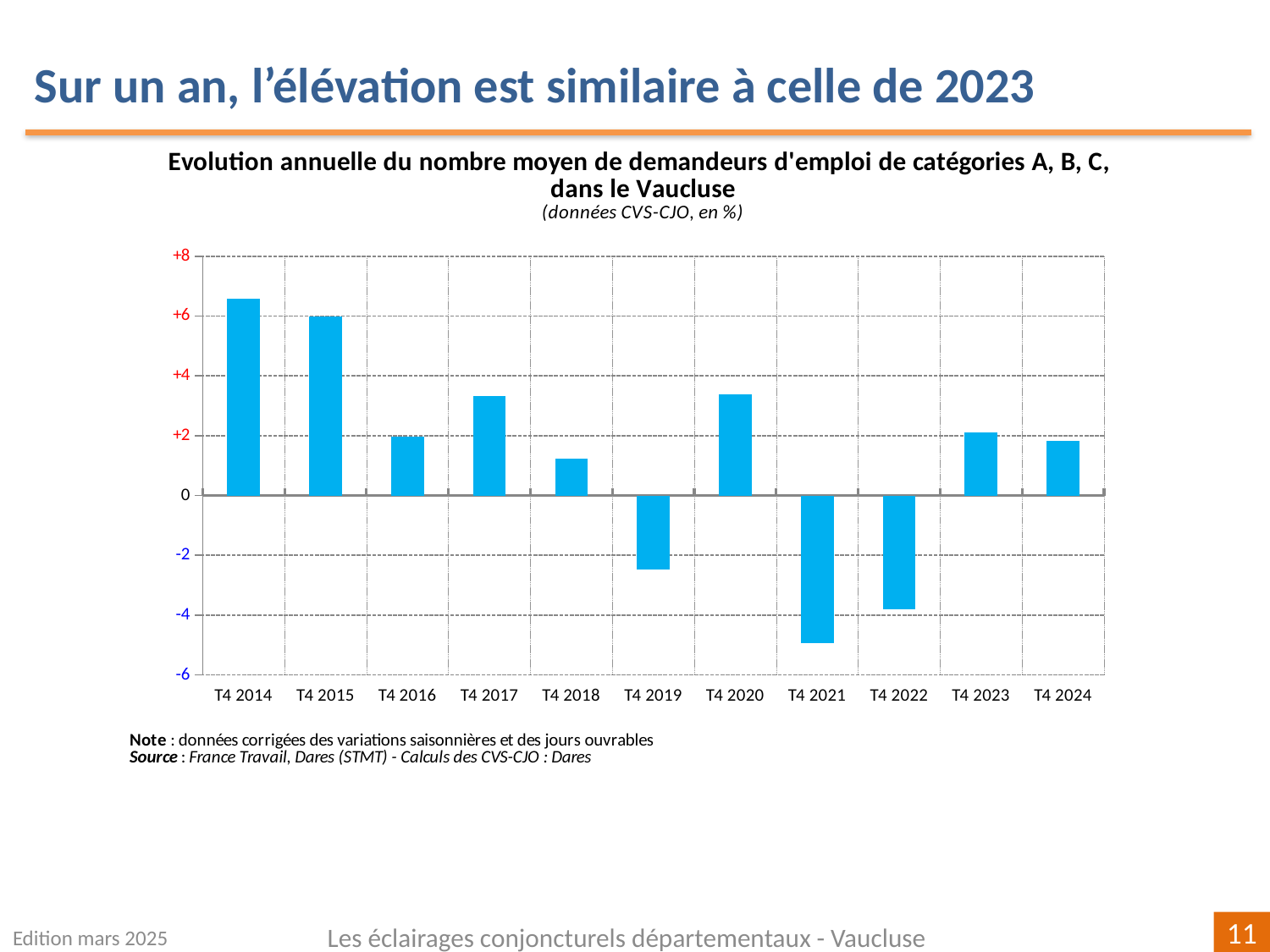
Is the value for T4 2021 greater or less than -4? less In what unit are the data expressed, according to the chart subtitle? % Is the value for T4 2019 greater or less than -2? less Is the value for T4 2018 greater or less than +2? less Which is larger, the value for T4 2015 or the value for T4 2017? T4 2015 Which is larger, the value for T4 2021 or the value for T4 2022? T4 2022 Which quarter has the highest annual evolution value? T4 2014 What kind of chart is shown on the slide? bar chart Which quarter has the lowest annual evolution value? T4 2021 How many quarters (categories) are plotted on the x axis? 11